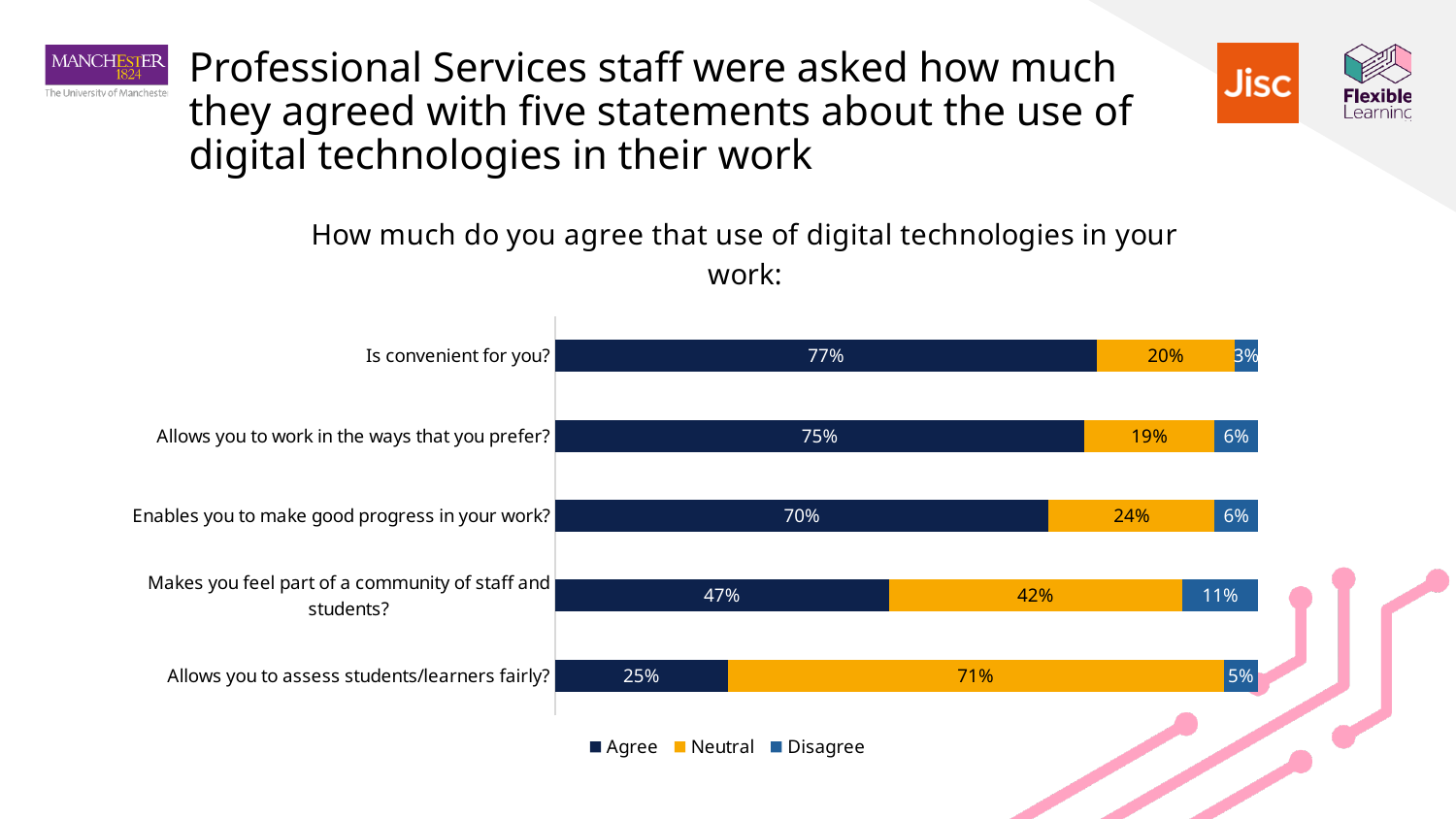
How many statements are shown in the chart? 5 Which is larger: the Neutral value for 'Makes you feel part of a community of staff and students?' or the Neutral value for 'Allows you to work in the ways that you prefer?' Makes you feel part of a community of staff and students? Which statement has the lowest Agree percentage? Allows you to assess students/learners fairly? What is the Disagree value for 'Makes you feel part of a community of staff and students?' 11% Which statement has the highest Agree percentage? Is convenient for you? What percentage of Professional Services staff agreed that use of digital technologies in their work is convenient for them? 77% What is the difference between the Agree percentages for 'Is convenient for you?' and 'Allows you to assess students/learners fairly?' 52% What kind of chart is shown on the slide? Stacked bar chart What are the three legend entries in the chart? Agree, Neutral, Disagree How many series does the legend list? 3 What is the Neutral value for 'Allows you to assess students/learners fairly?' 71% What is the Neutral value for 'Enables you to make good progress in your work?' 24%